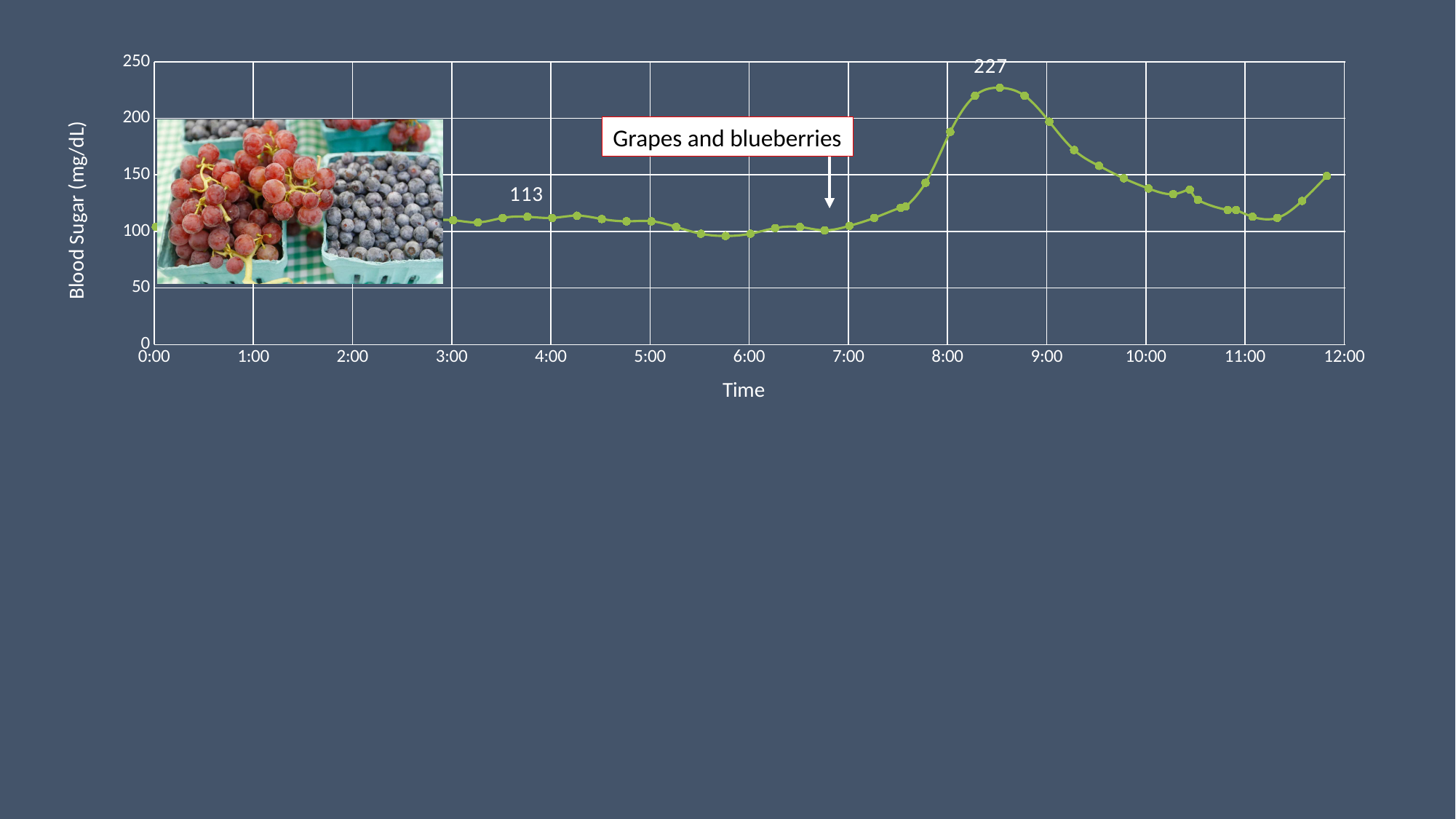
What blood sugar value is labelled on the line shortly before 4:00? 113 What kind of chart is shown on the slide? line chart Is the blood sugar value at 8:00 greater or less than 150? greater Between 8:30 and 11:00, does the blood sugar line rise or fall? fall Is the blood sugar value at 11:00 greater or less than 150? less Which is larger, the blood sugar value at 9:00 or at 4:00? 9:00 Between 7:00 and 8:30, does the blood sugar line rise or fall? rise What is the difference between the two labelled values, 227 and 113? 114 Is the blood sugar value at 9:00 greater or less than 150? greater What does the annotation box with the arrow on the chart say? Grapes and blueberries What is the highest blood sugar value labelled on the chart? 227 What is the label on the vertical axis of the chart? Blood Sugar (mg/dL)